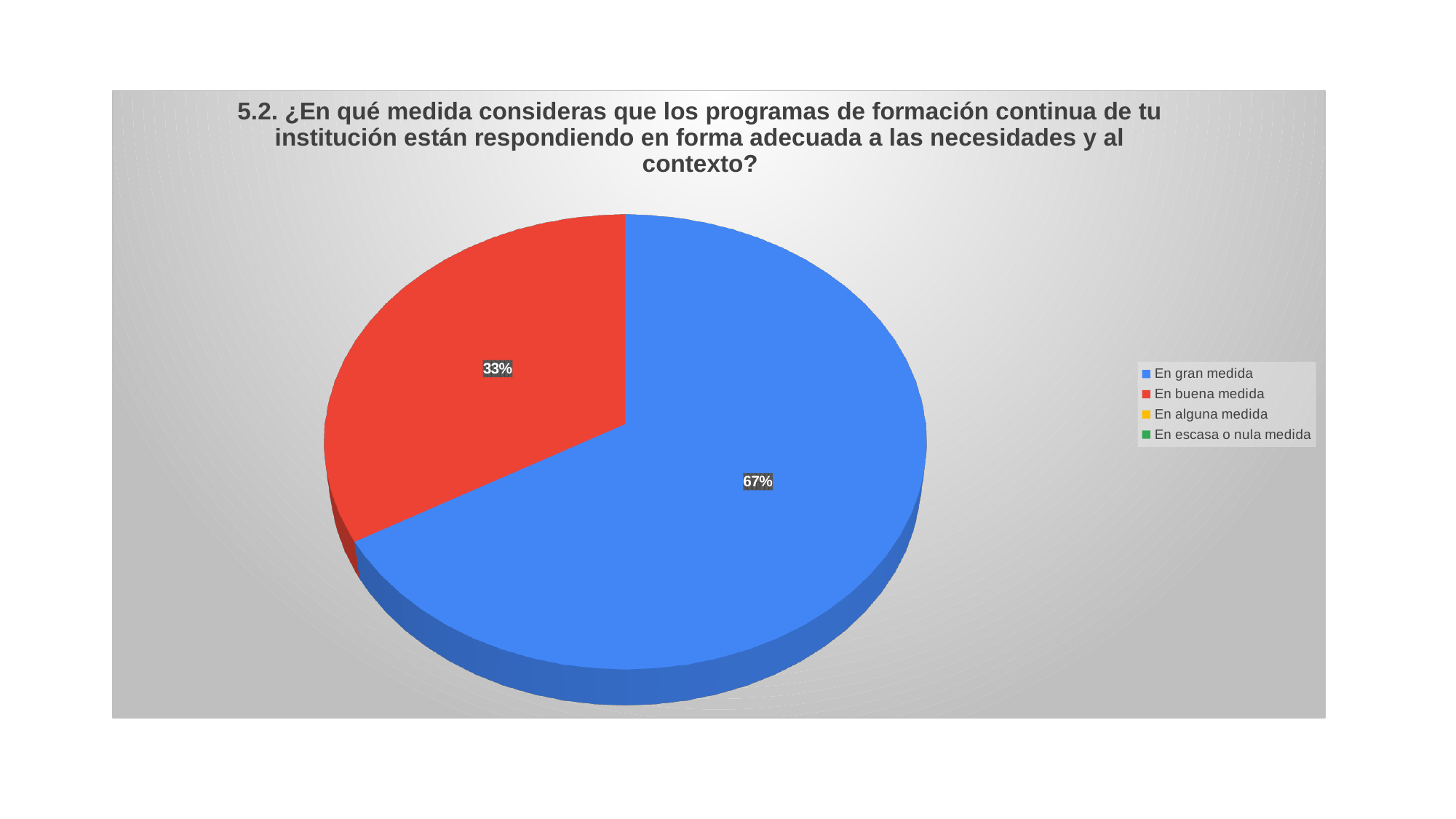
What is the difference in percentage points between the "En gran medida" slice and the "En buena medida" slice? 34% Which category has the largest slice of the pie? En gran medida What kind of chart is shown on the slide? Pie chart Which legend entry is shown in blue? En gran medida Which is larger, the slice for "En gran medida" or the slice for "En buena medida"? En gran medida What share of the pie does "En gran medida" represent? 67% What colour is the slice for "En buena medida"? Red How many slices with a visible data label are shown in the pie? 2 How many entries does the legend list? 4 What share of the pie does "En buena medida" represent? 33%